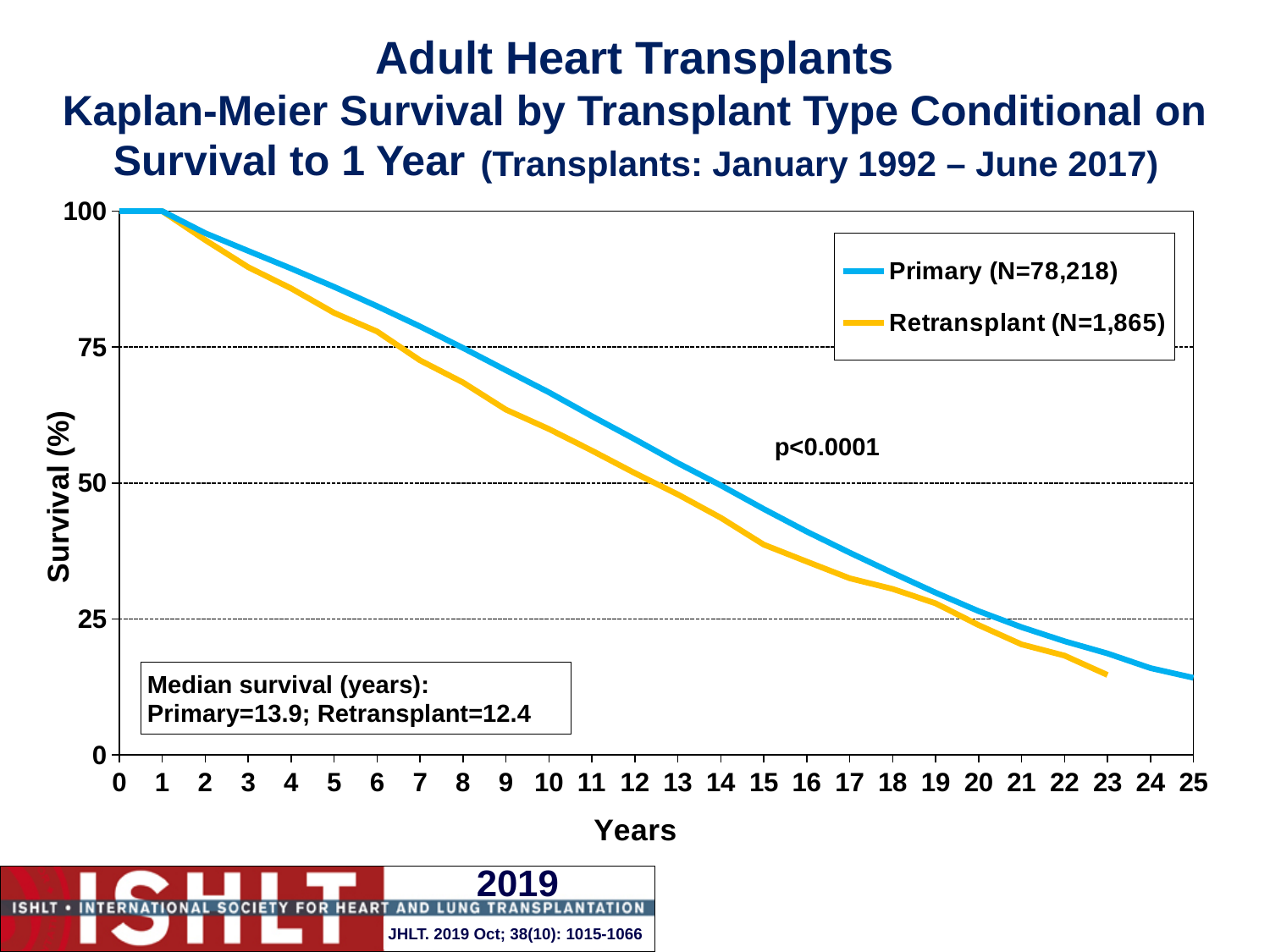
How many series does the legend list? 2 What is the number of patients (N) in the Retransplant group? 1,865 What is the median survival in years for the Retransplant group? 12.4 What is the median survival in years for the Primary group? 13.9 Which group has the longer median survival, Primary or Retransplant? Primary What p-value is shown on the chart? p<0.0001 Is the survival value for the Primary curve at 5 years greater or less than 75? greater At 10 years, which curve shows higher survival, Primary or Retransplant? Primary What is the number of patients (N) in the Primary group? 78,218 Do the survival curves rise or fall as years increase? Fall What kind of chart is shown on the slide? Line chart Is the survival value for the Retransplant curve at 15 years greater or less than 50? less